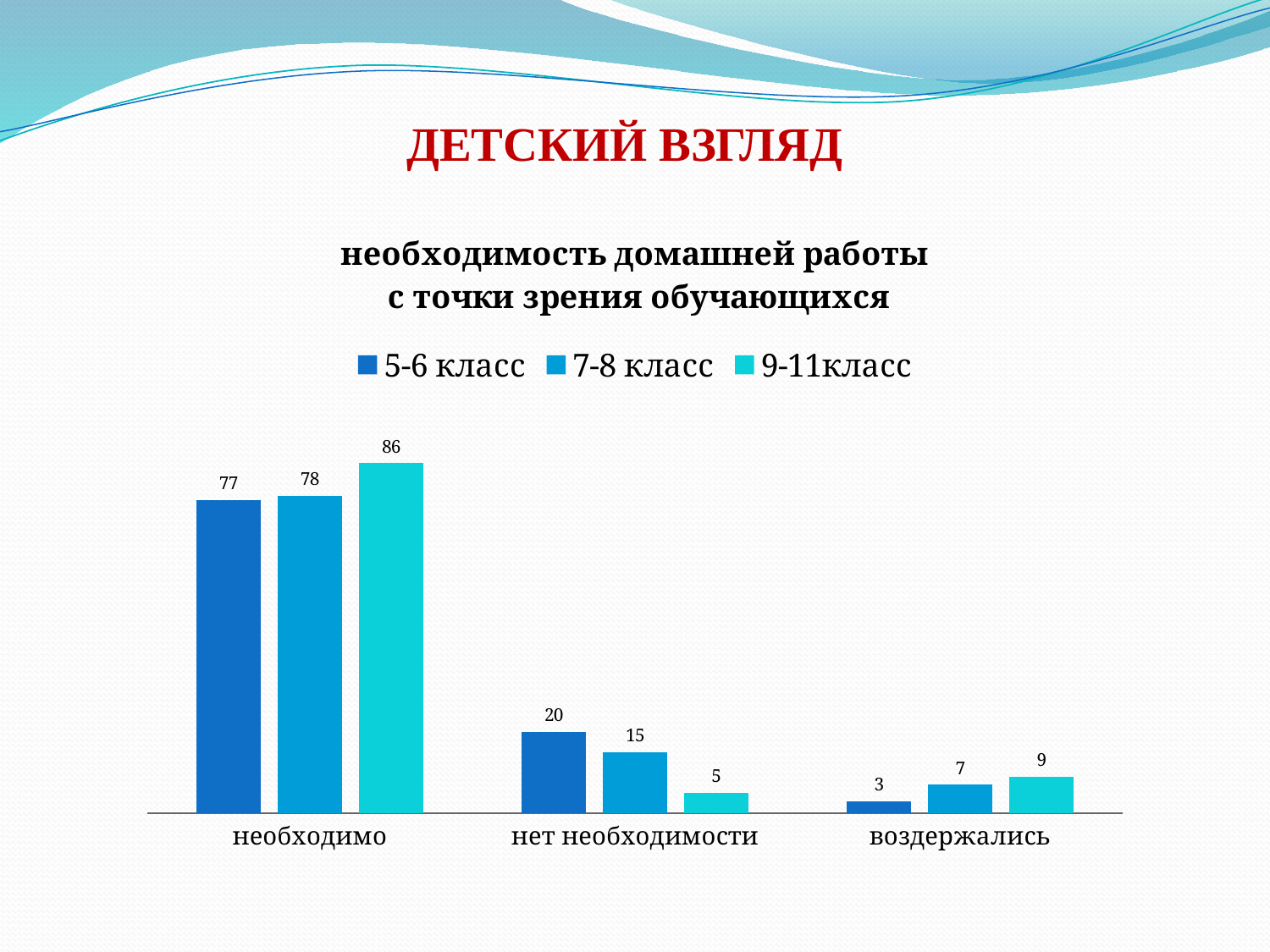
What is the value for 9-11класс in the необходимо category? 86 Which series has the lowest value in the воздержались category? 5-6 класс Which is larger: the 7-8 класс value for необходимо or the 5-6 класс value for необходимо? 7-8 класс How many series does the legend list? 3 Do the values for 9-11класс rise or fall from необходимо to воздержались? fall What is the value for 5-6 класс in the нет необходимости category? 20 Which series has the highest value in the необходимо category? 9-11класс What kind of chart is shown on the slide? bar chart How many categories are shown on the x axis? 3 What is the difference between the 5-6 класс and 9-11класс values in the нет необходимости category? 15 What is the title of the chart? необходимость домашней работы с точки зрения обучающихся What is the value for 7-8 класс in the воздержались category? 7